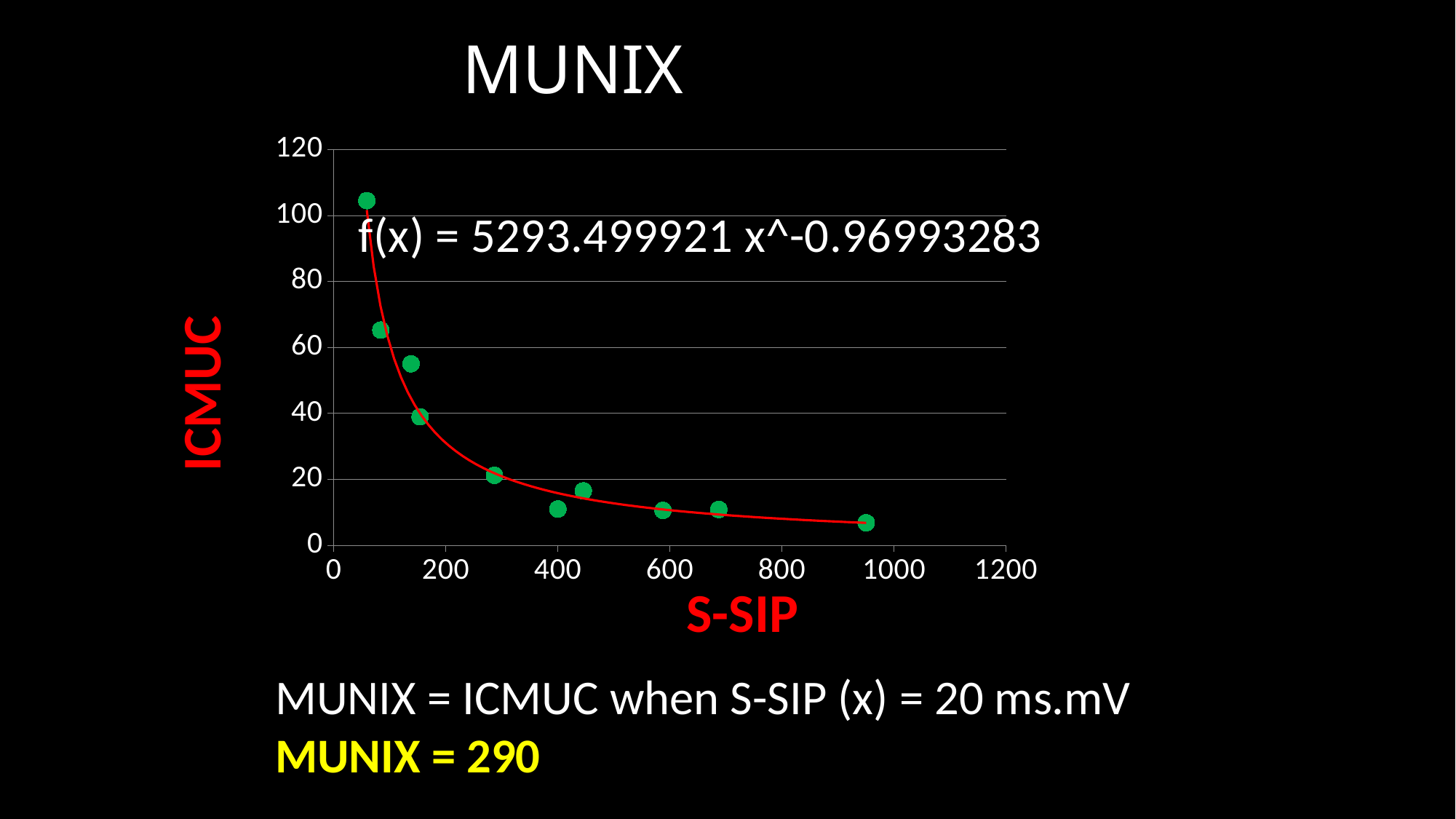
How many data points are plotted on the chart? 10 Is the ICMUC value of the rightmost data point greater or less than 20? less Is the S-SIP value of the rightmost data point greater or less than 800? greater What is the trendline equation printed on the chart? f(x) = 5293.499921 x^-0.96993283 Which has the higher ICMUC value: the data point near S-SIP = 60 or the data point near S-SIP = 950? the data point near S-SIP = 60 What is the maximum value shown on the y axis? 120 What is the label of the x axis? S-SIP What kind of chart is shown on the slide? scatter chart Is the ICMUC value of the data point near S-SIP = 290 greater or less than 40? less Do the ICMUC values rise or fall as S-SIP increases along the x axis? fall